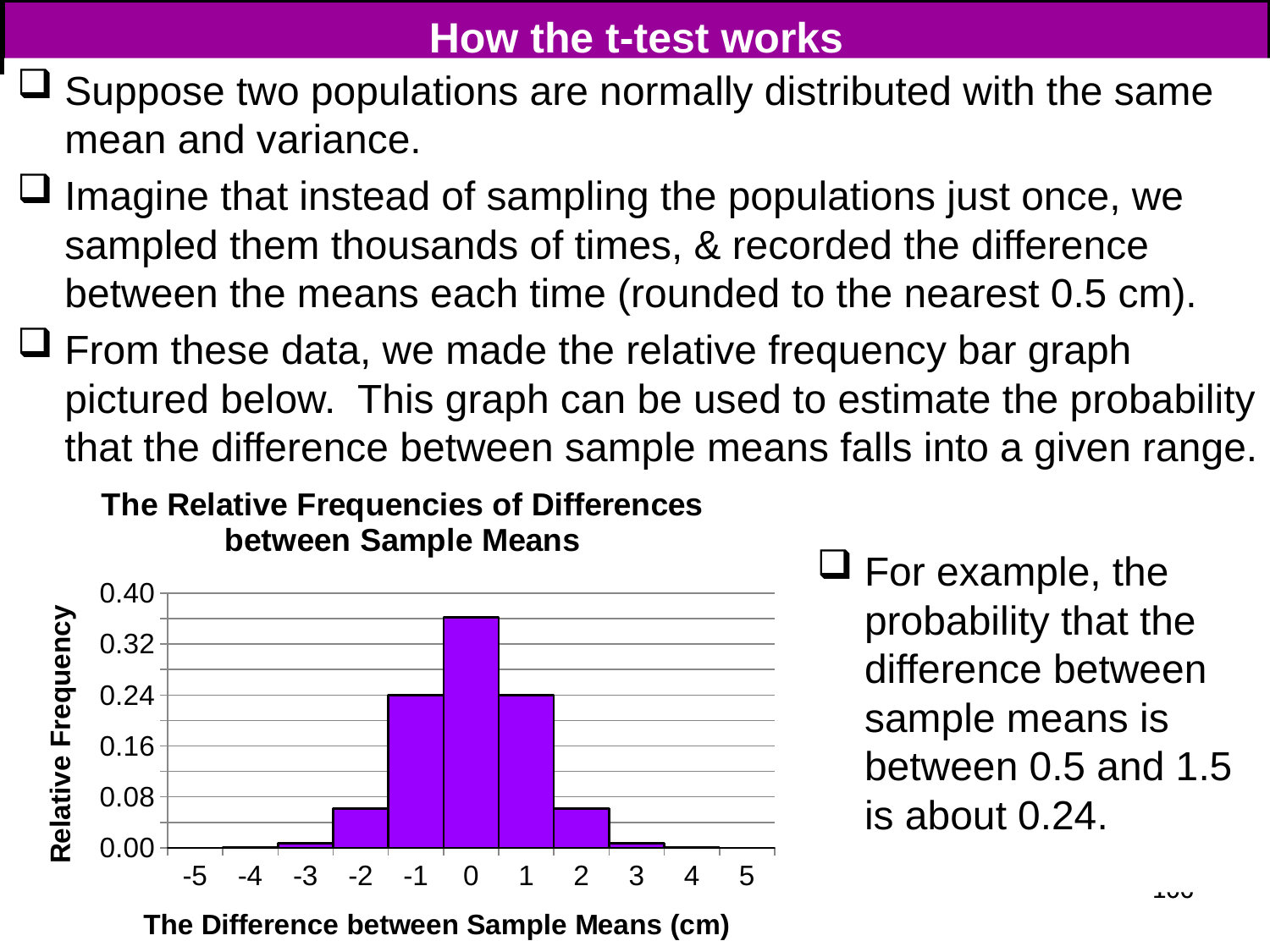
Is the relative frequency for a difference of -1 greater or less than 0.16? greater Is the relative frequency for a difference of 0 greater or less than 0.32? greater How many categories are shown on the x axis of the chart? 11 What is the title of the x axis of the chart? The Difference between Sample Means (cm) Do the relative frequencies rise or fall as the difference goes from -5 to 0? rise Which has the larger relative frequency, a difference of 0 or a difference of 1? 0 What is the relative frequency for a difference of 1 cm? 0.24 What kind of chart is shown on the slide? bar chart What is the title of the y axis of the chart? Relative Frequency Is the relative frequency for a difference of 2 greater or less than 0.08? less Which has the larger relative frequency, a difference of -2 or a difference of -3? -2 Which difference between sample means has the highest relative frequency? 0